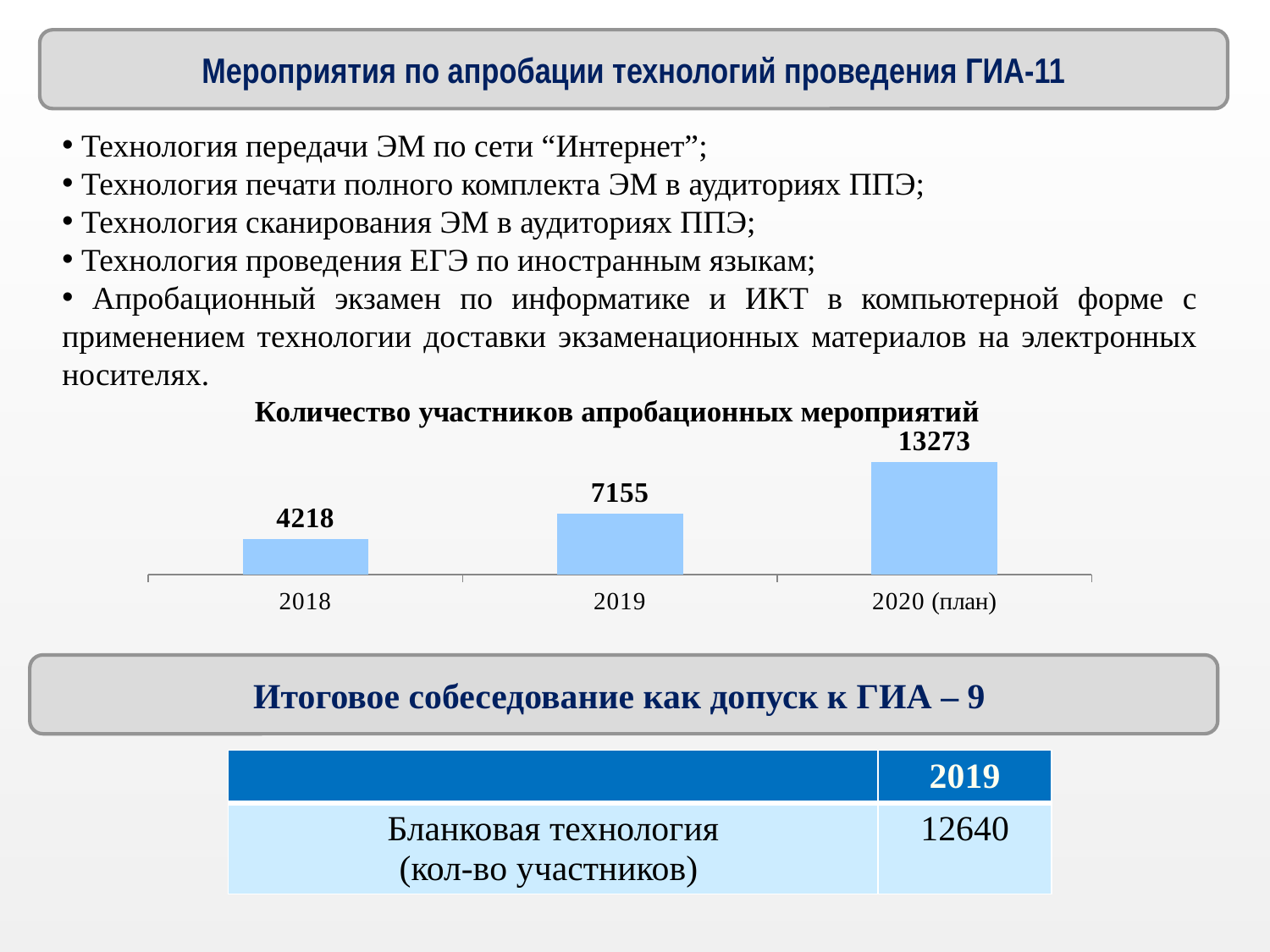
What is the difference between the values for 2019 and 2018 in the chart 'Количество участников апробационных мероприятий'? 2937 What is the value for 2019 in the chart 'Количество участников апробационных мероприятий'? 7155 Do the values rise or fall from 2018 to 2020 (план) in the chart 'Количество участников апробационных мероприятий'? rise Which category has the lowest value in the chart 'Количество участников апробационных мероприятий'? 2018 What is the value for 2020 (план) in the chart 'Количество участников апробационных мероприятий'? 13273 In the chart 'Количество участников апробационных мероприятий', which is larger: the value for 2019 or the value for 2018? 2019 What kind of chart is 'Количество участников апробационных мероприятий'? bar chart What is the difference between the values for 2020 (план) and 2019 in the chart 'Количество участников апробационных мероприятий'? 6118 How many categories are shown in the chart 'Количество участников апробационных мероприятий'? 3 Which category has the highest value in the chart 'Количество участников апробационных мероприятий'? 2020 (план) What is the title of the bar chart on the slide? Количество участников апробационных мероприятий What is the value for 2018 in the chart 'Количество участников апробационных мероприятий'? 4218